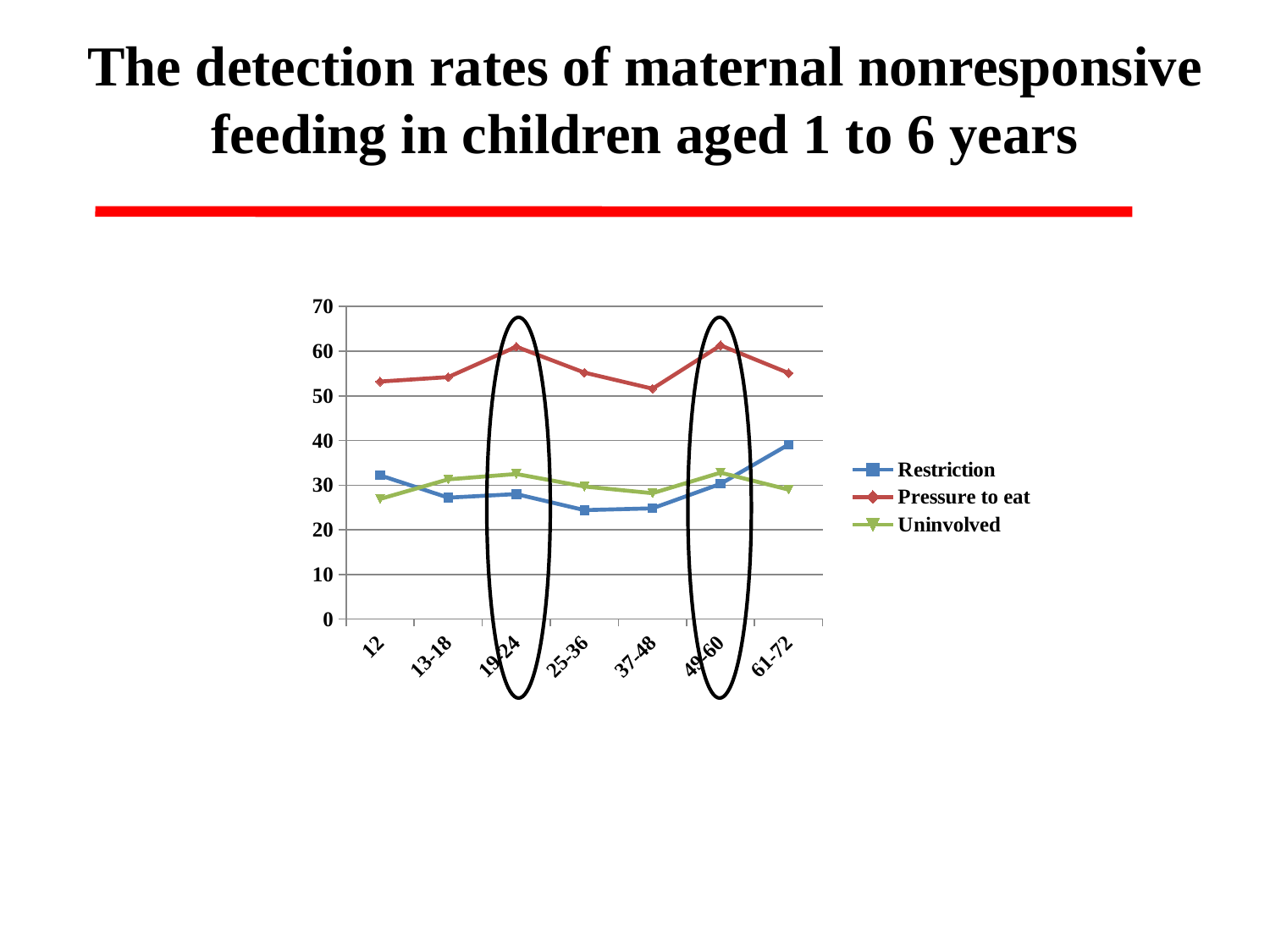
Is the value for Uninvolved at age 12 greater or less than 30? less At age 12, which is larger: Restriction or Uninvolved? Restriction At 13-18, which is larger: Restriction or Uninvolved? Uninvolved At which age group is the Restriction series highest? 61-72 Is the value for Pressure to eat at age 12 greater or less than 50? greater What kind of chart is shown on the slide? line chart How many age-group categories are shown on the x axis? 7 How many series does the legend list? 3 Is the value for Restriction at 25-36 greater or less than 20? greater Does the Restriction series rise or fall from 37-48 to 61-72? rise Which series has the highest values across all age groups? Pressure to eat